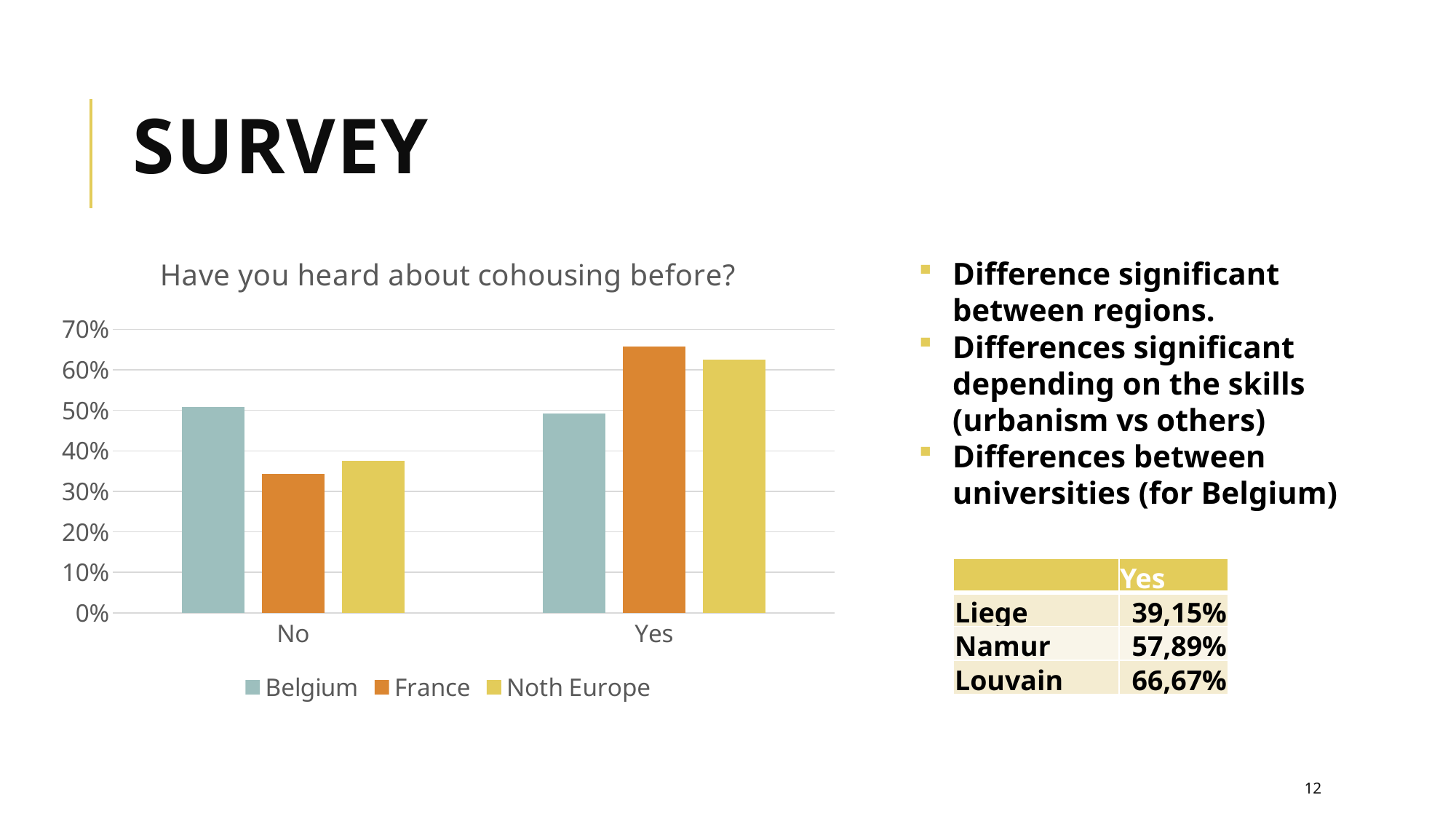
What is the title of the chart? Have you heard about cohousing before? In the "Yes" category, which series has the lowest bar? Belgium Which series is shown in orange in the chart? France What kind of chart is shown on the slide? bar chart In the "No" category, which series has the lowest bar? France In the "Yes" category, which series has the highest bar? France How many series does the chart legend list? 3 In the "No" category, which series has the highest bar? Belgium Is the value for France in the "Yes" category greater or less than 60%? greater How many categories are shown on the x axis of the chart? 2 For France, is the value for "Yes" larger or smaller than the value for "No"? larger Is the value for France in the "No" category greater or less than 40%? less